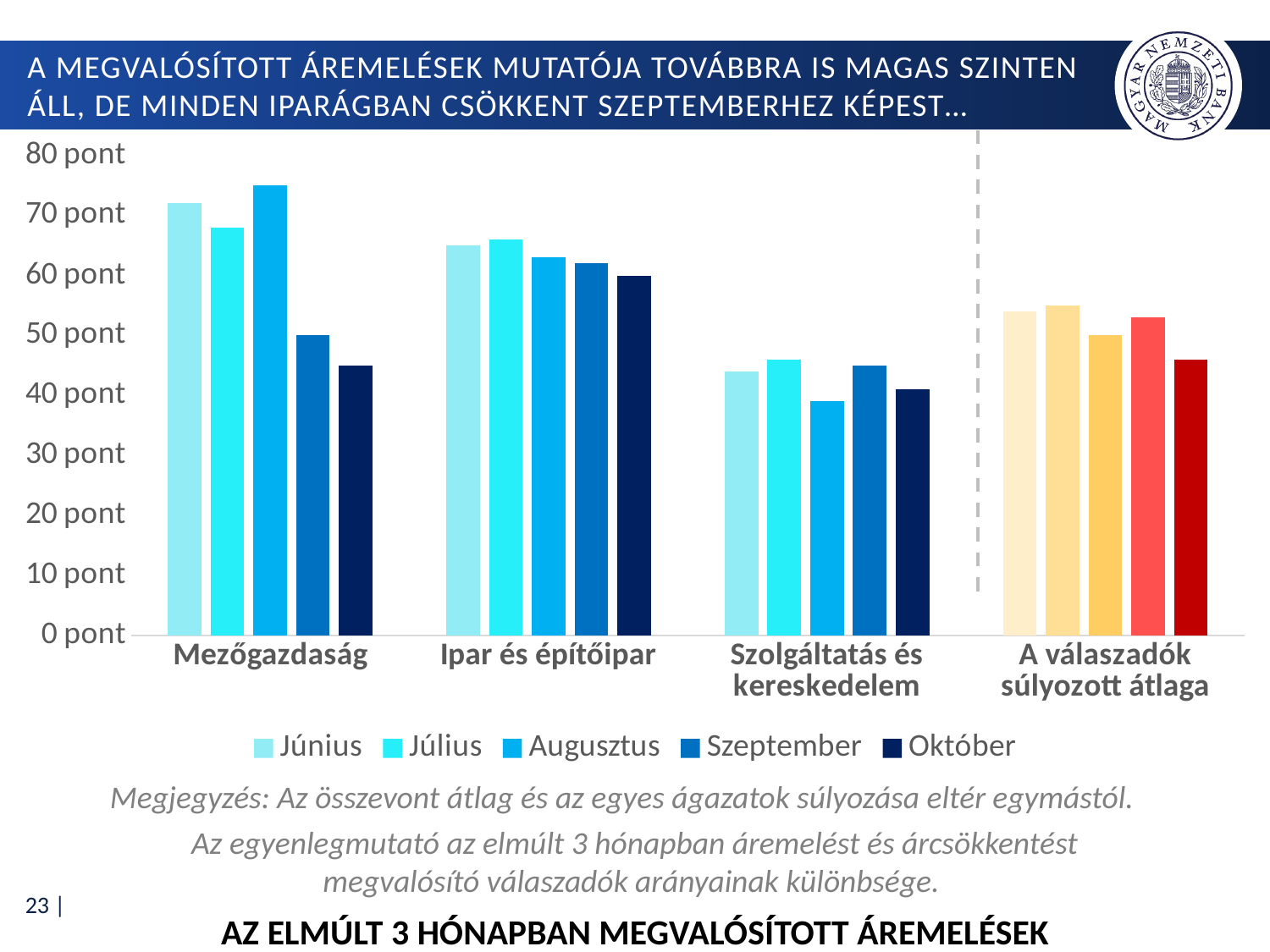
Which series is listed first in the legend? Június Which is larger: the Június value for Mezőgazdaság or the Június value for Szolgáltatás és kereskedelem? Mezőgazdaság Is the Augusztus value for Mezőgazdaság greater or less than 70 pont? greater Is the Szeptember value for Mezőgazdaság greater or less than 60 pont? less For Ipar és építőipar, do the values rise or fall from Július to Október? fall What kind of chart is shown on the slide? bar chart How many categories are shown on the x axis? 4 How many series does the legend list? 5 Which is larger: the Október value for Mezőgazdaság or the Október value for Ipar és építőipar? Ipar és építőipar For Mezőgazdaság, which month has the highest bar? Augusztus Is the Június value for Ipar és építőipar greater or less than 60 pont? greater For Mezőgazdaság, which month has the lowest bar? Október